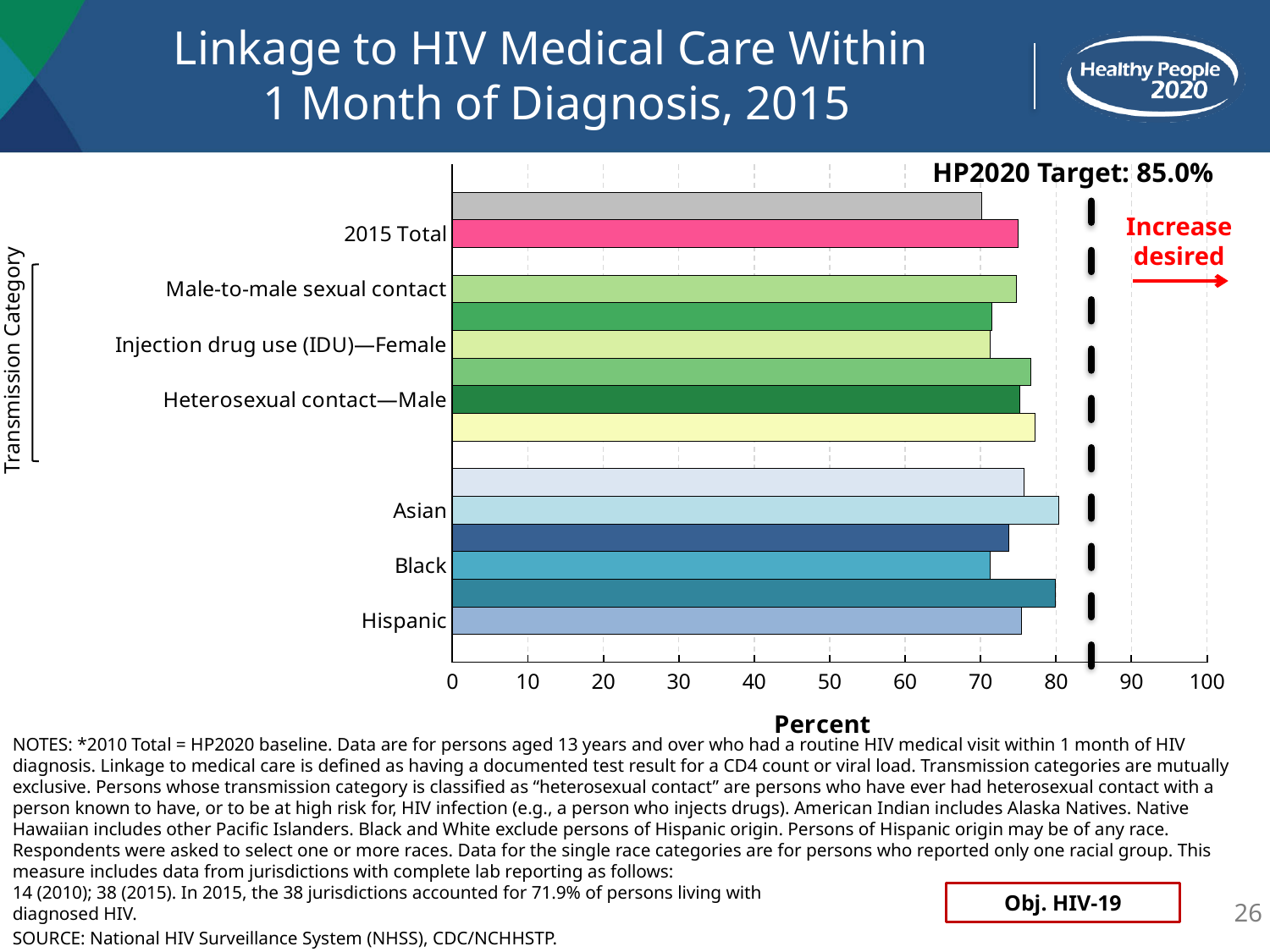
Which has the larger value, Hispanic or Black? Hispanic Is the value for 2015 Total greater or less than 80? less Is the value for 2015 Total greater or less than 70? greater Is the value for Male-to-male sexual contact greater or less than 80? less What is the HP2020 Target value shown on the chart? 85.0% Which has the larger value, Asian or Black? Asian What kind of chart is shown on the slide? Bar chart What is the label of the x axis? Percent